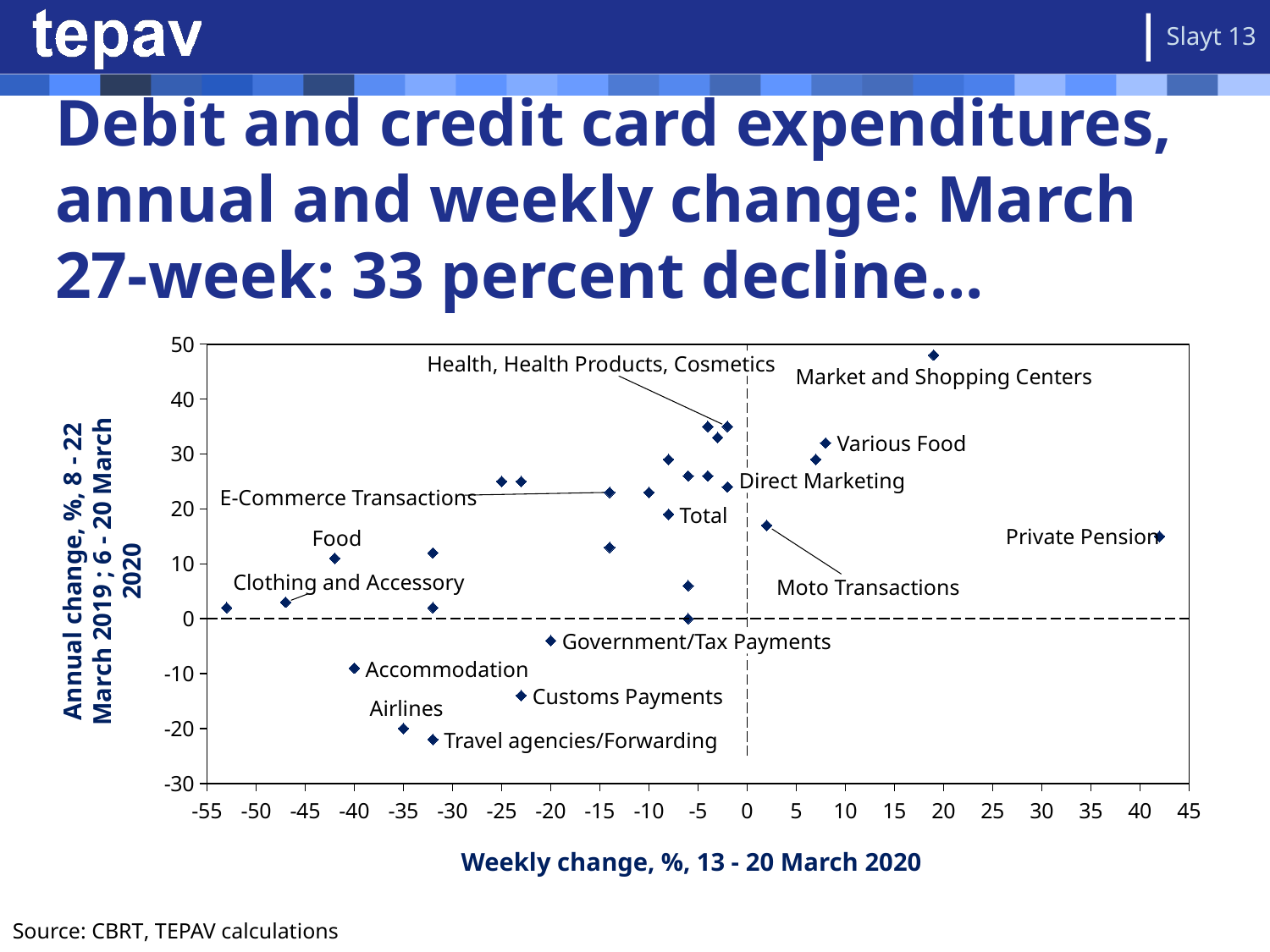
Which has the higher weekly change, Private Pension or Food? Private Pension Is the annual change for Market and Shopping Centers greater or less than 40? greater Is the weekly change for Food greater or less than -30? less Which labeled category has the highest annual change? Market and Shopping Centers Is the annual change for Accommodation greater or less than 0? less What kind of chart is shown on the slide? Scatter chart Which has the higher annual change, Market and Shopping Centers or Airlines? Market and Shopping Centers What is the title of the horizontal axis of the chart? Weekly change, %, 13 - 20 March 2020